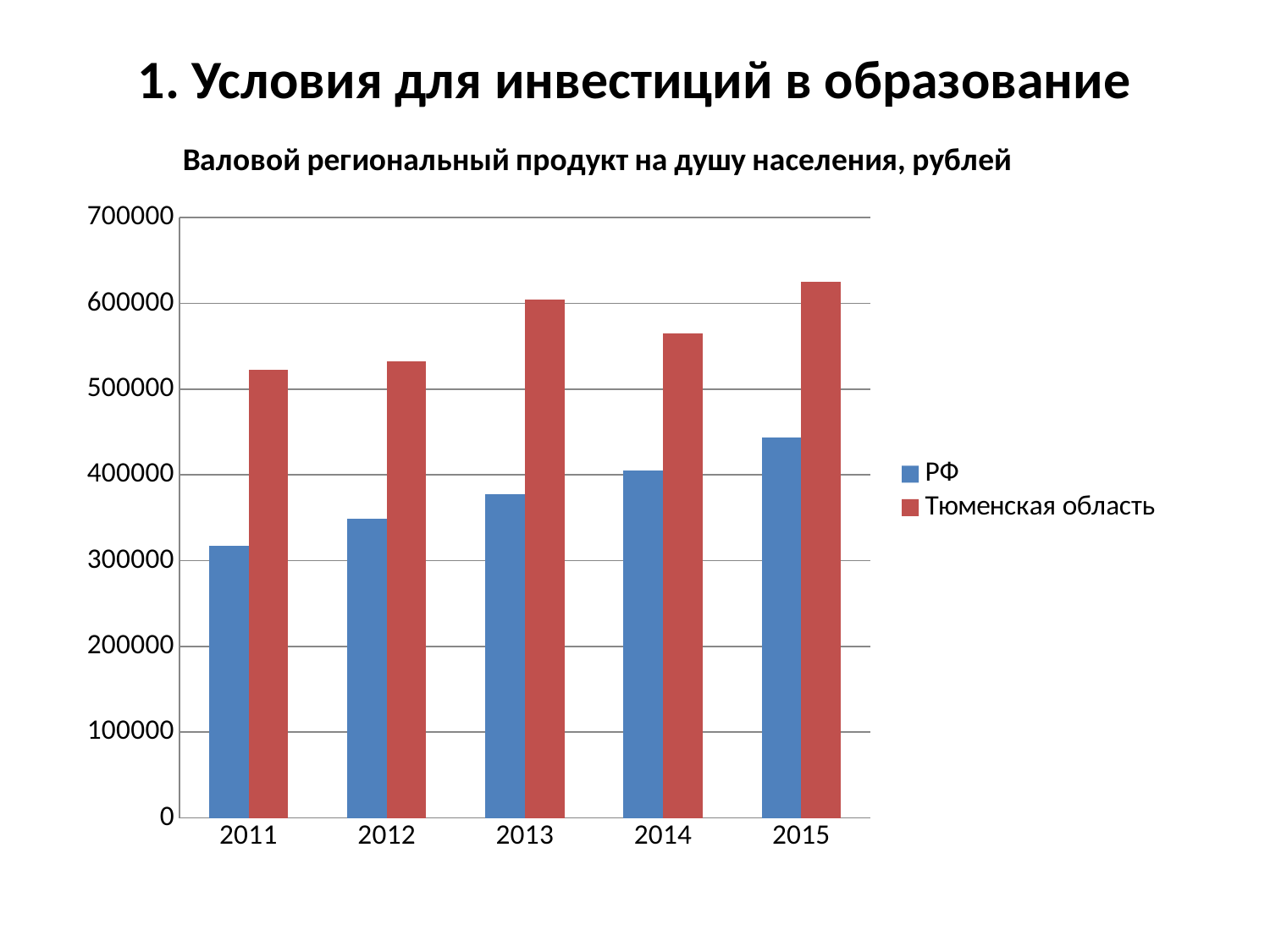
Which series is shown in red? Тюменская область In which year is the value for Тюменская область highest? 2015 What kind of chart is shown on the slide? Bar chart How many series does the legend list? 2 In 2015, which series has the larger value: РФ or Тюменская область? Тюменская область Is the value for Тюменская область in 2015 greater or less than 600000? greater What is the title of the chart? Валовой региональный продукт на душу населения, рублей How many years are shown on the x axis? 5 Which is larger for Тюменская область: the value for 2013 or the value for 2014? 2013 Do the values for РФ rise or fall from 2011 to 2015? Rise Is the value for РФ in 2012 greater or less than 400000? less In which year is the value for РФ lowest? 2011